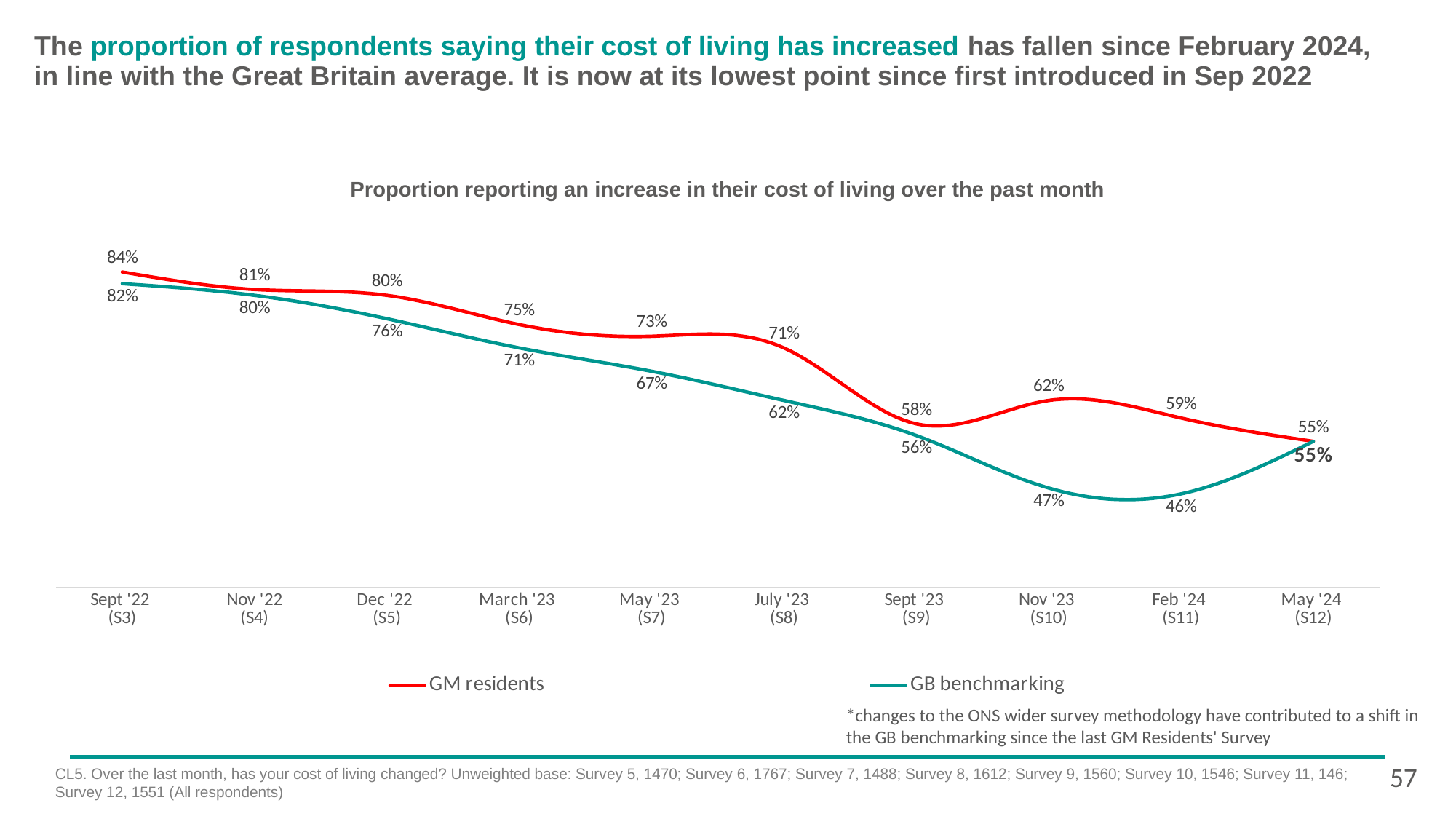
How many survey waves are shown on the x axis? 10 What is the value for GB benchmarking in Feb '24 (S11)? 46% How many series does the legend list? 2 In which survey wave is the GM residents value lowest? May '24 (S12) What is the value for GM residents in Sept '22 (S3)? 84% What kind of chart is shown on the slide? Line chart What is the value for GM residents in Nov '23 (S10)? 62% Which series has the higher value in July '23 (S8), GM residents or GB benchmarking? GM residents In which survey wave is the GB benchmarking value highest? Sept '22 (S3) What is the value for GB benchmarking in May '23 (S7)? 67% What is the difference between the GM residents and GB benchmarking values in Nov '23 (S10)? 15 percentage points Does the GM residents series generally rise or fall from Sept '22 to May '24? Fall